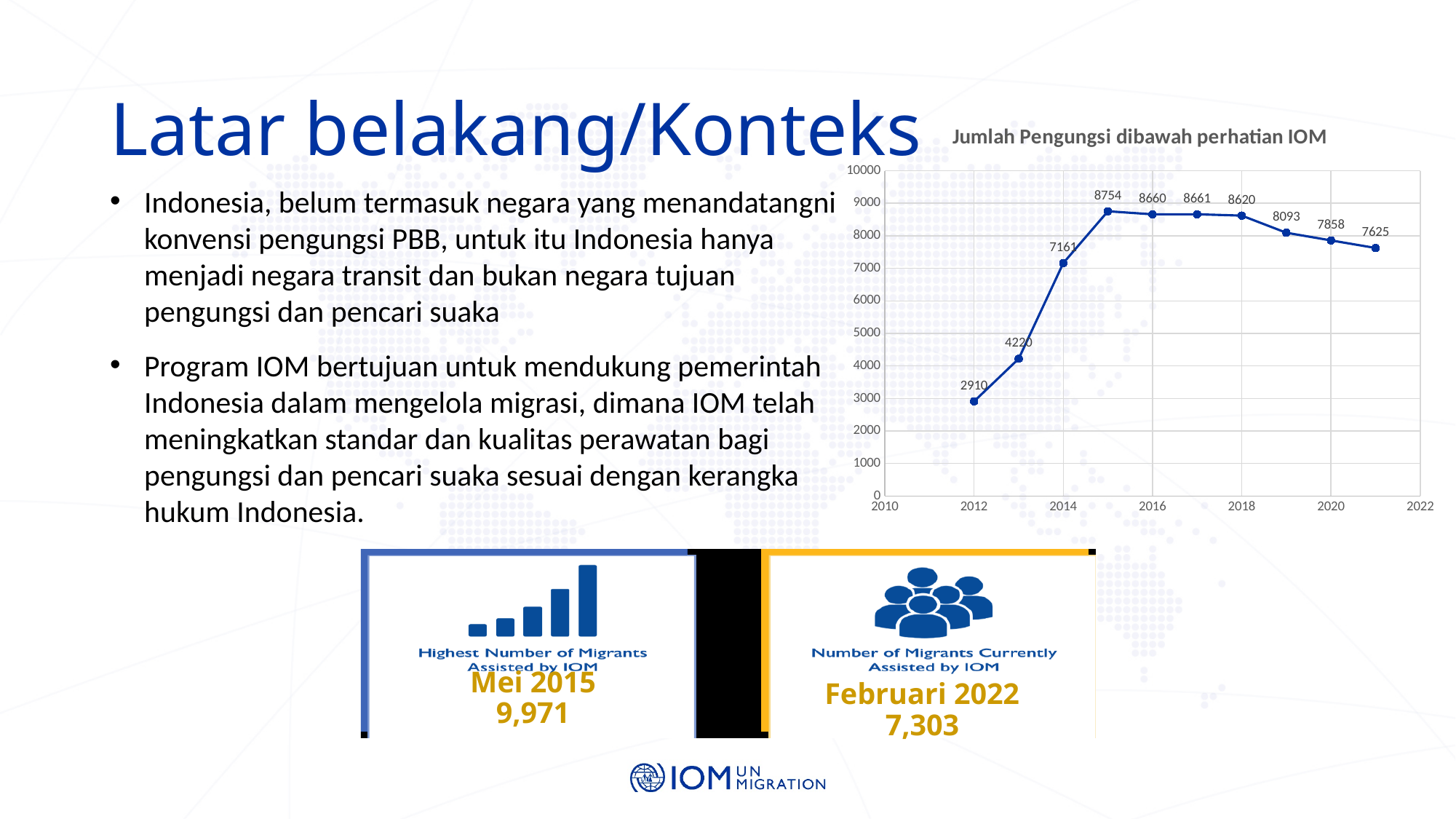
What is the value for 2012 in the chart "Jumlah Pengungsi dibawah perhatian IOM"? 2910 How many data points are plotted in the chart "Jumlah Pengungsi dibawah perhatian IOM"? 10 In the chart "Jumlah Pengungsi dibawah perhatian IOM", which is larger: the value for 2018 or the value for 2020? 2018 In which year does the chart "Jumlah Pengungsi dibawah perhatian IOM" show its lowest value? 2012 In the chart "Jumlah Pengungsi dibawah perhatian IOM", is the value for 2013 greater or less than 5000? less What is the value for 2021 in the chart "Jumlah Pengungsi dibawah perhatian IOM"? 7625 What is the value for 2019 in the chart "Jumlah Pengungsi dibawah perhatian IOM"? 8093 In the chart "Jumlah Pengungsi dibawah perhatian IOM", what is the difference between the values for 2014 and 2013? 2941 In which year does the chart "Jumlah Pengungsi dibawah perhatian IOM" reach its highest value? 2015 What is the value for 2015 in the chart "Jumlah Pengungsi dibawah perhatian IOM"? 8754 In the chart "Jumlah Pengungsi dibawah perhatian IOM", do the values rise or fall from 2018 to 2021? fall What type of chart is "Jumlah Pengungsi dibawah perhatian IOM"? line chart